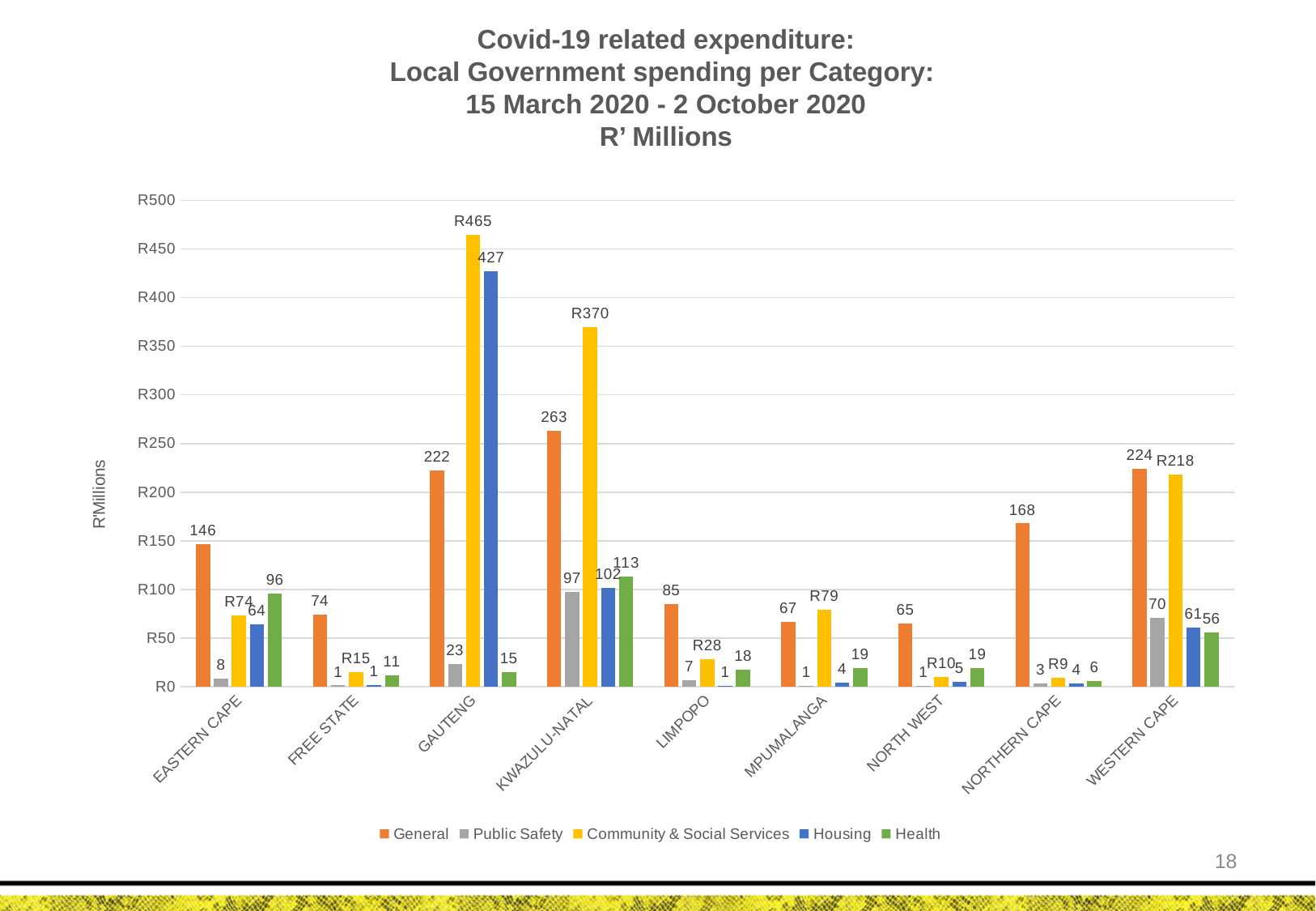
What is the General value for KwaZulu-Natal? 263 What is the Housing value for Gauteng? 427 What is the label of the vertical axis? R'Millions What is the Health value for Eastern Cape? 96 Which is larger, the Public Safety value for KwaZulu-Natal or for Western Cape? KwaZulu-Natal How many provinces are shown on the x axis? 9 Which province has the lowest Community & Social Services value? Northern Cape What is the difference between the General values for Western Cape and Gauteng? 2 How many series does the legend list? 5 Which province has the highest General value? KwaZulu-Natal What kind of chart is shown on the slide? Bar chart What is the Community & Social Services value for Gauteng? R465